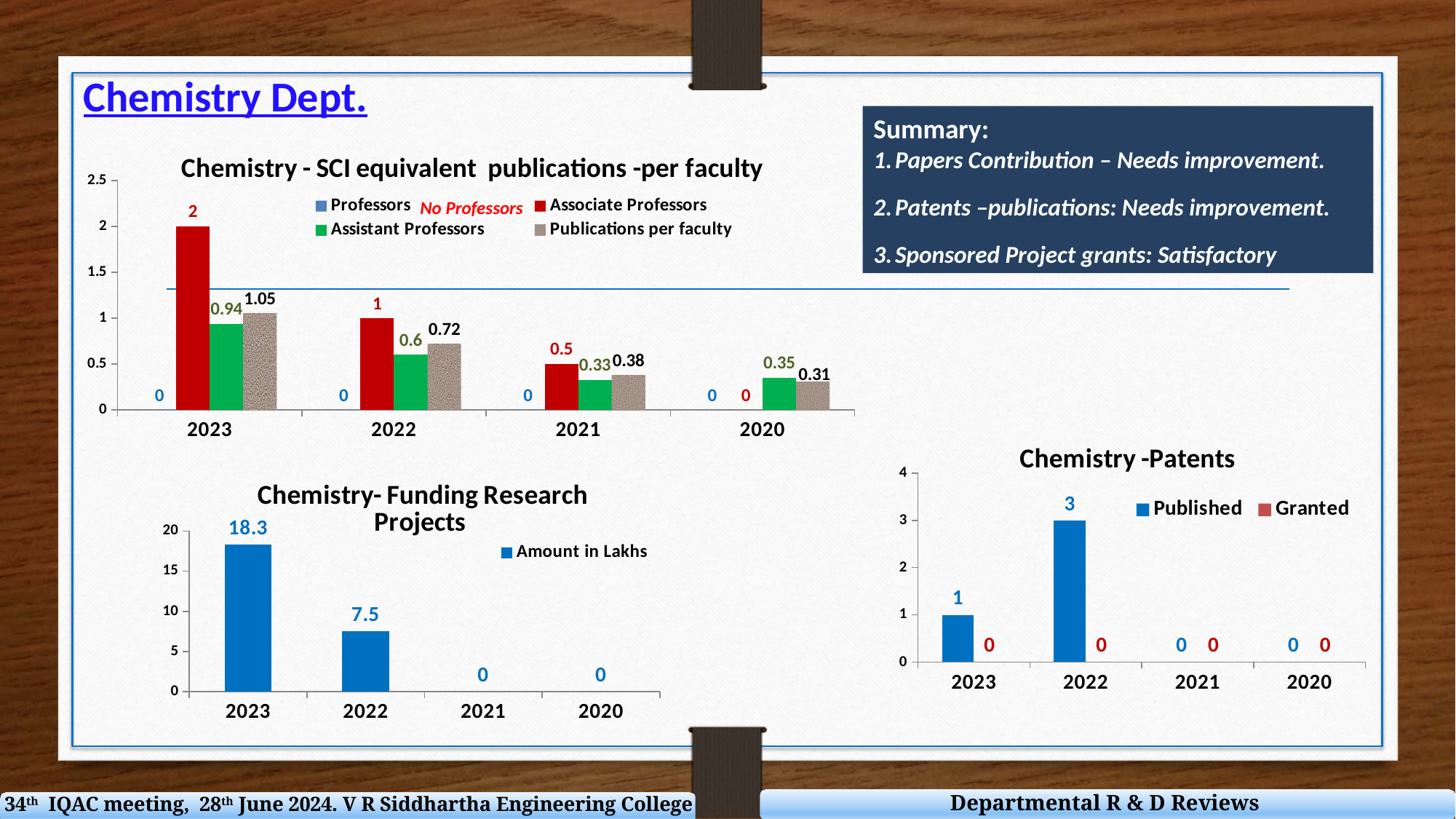
In the 'Chemistry - SCI equivalent publications -per faculty' chart, what is the difference between the Associate Professors values for 2023 and 2022? 1 In the 'Chemistry - SCI equivalent publications -per faculty' chart, what is the value for Assistant Professors in 2020? 0.35 In the 'Chemistry -Patents' chart, how many patents were published in 2022? 3 In the 'Chemistry- Funding Research Projects' chart, how many years are shown on the x axis? 4 In the 'Chemistry- Funding Research Projects' chart, what is the amount in lakhs for 2023? 18.3 What type of chart is the 'Chemistry -Patents' chart? Bar chart In the 'Chemistry- Funding Research Projects' chart, what is the difference between the 2023 and 2022 amounts? 10.8 In the 'Chemistry - SCI equivalent publications -per faculty' chart, what is the value for Associate Professors in 2023? 2 In the 'Chemistry - SCI equivalent publications -per faculty' chart, what is the Publications per faculty value for 2022? 0.72 In the 'Chemistry - SCI equivalent publications -per faculty' chart, how many series does the legend list? 4 In the 'Chemistry -Patents' chart, which year has the highest number of published patents? 2022 In the 'Chemistry - SCI equivalent publications -per faculty' chart, which year has the highest Publications per faculty value? 2023